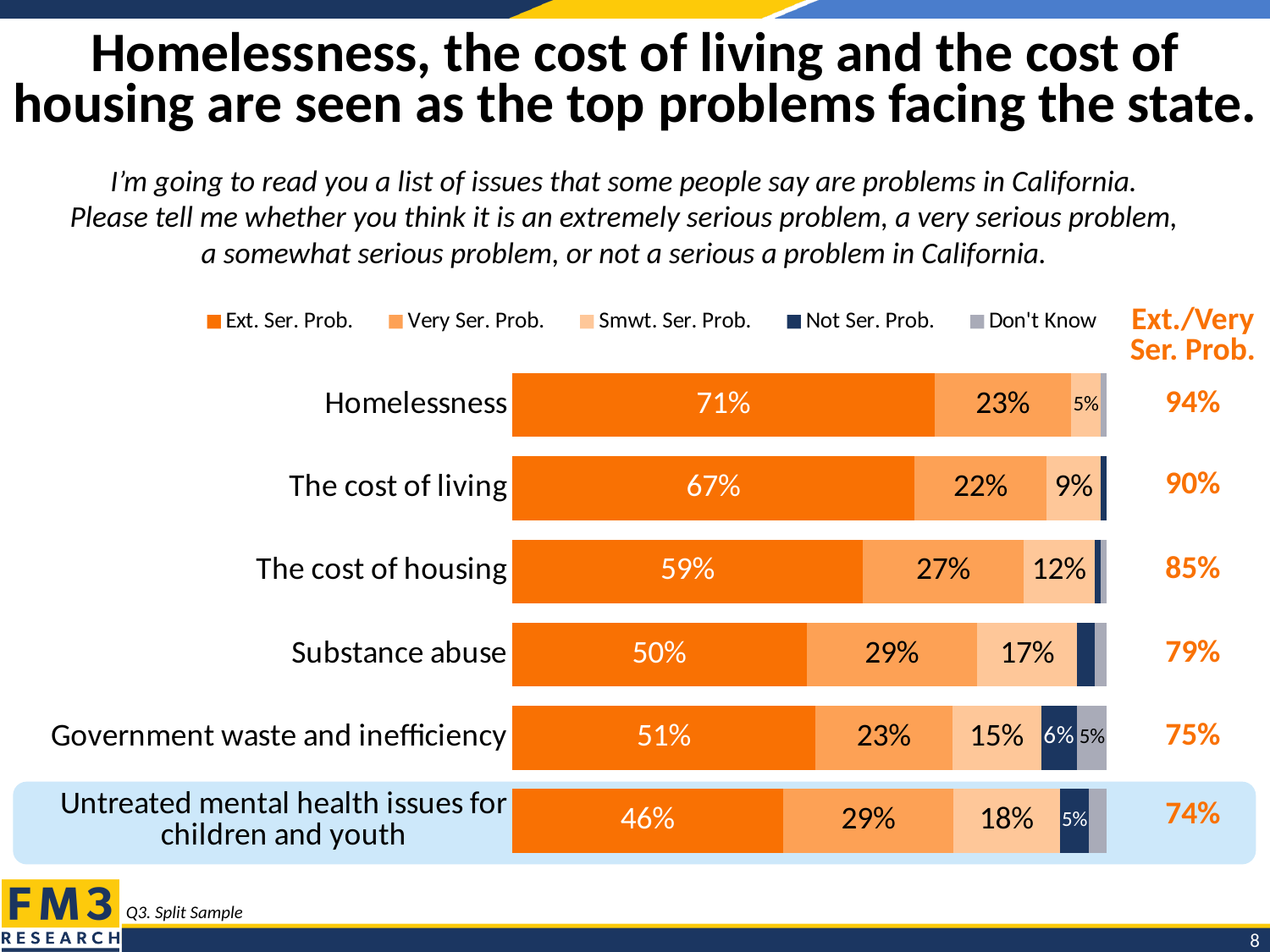
What is the Smwt. Ser. Prob. value for Substance abuse? 17% Which issue has the lowest Ext. Ser. Prob. value? Untreated mental health issues for children and youth Which has the larger Very Ser. Prob. value, Substance abuse or The cost of living? Substance abuse How many issues are listed in the chart? 6 What is the combined Ext./Very Ser. Prob. figure shown for The cost of living? 90% How many percentage points higher is the Ext. Ser. Prob. value for Homelessness than for The cost of living? 4 percentage points What kind of chart is shown on the slide? Stacked bar chart How many series does the legend list? 5 What is the Not Ser. Prob. value for Government waste and inefficiency? 6% Which issue has the highest Ext. Ser. Prob. value? Homelessness What is the Very Ser. Prob. value for The cost of housing? 27% What percentage of respondents rated Homelessness an extremely serious problem (Ext. Ser. Prob.)? 71%